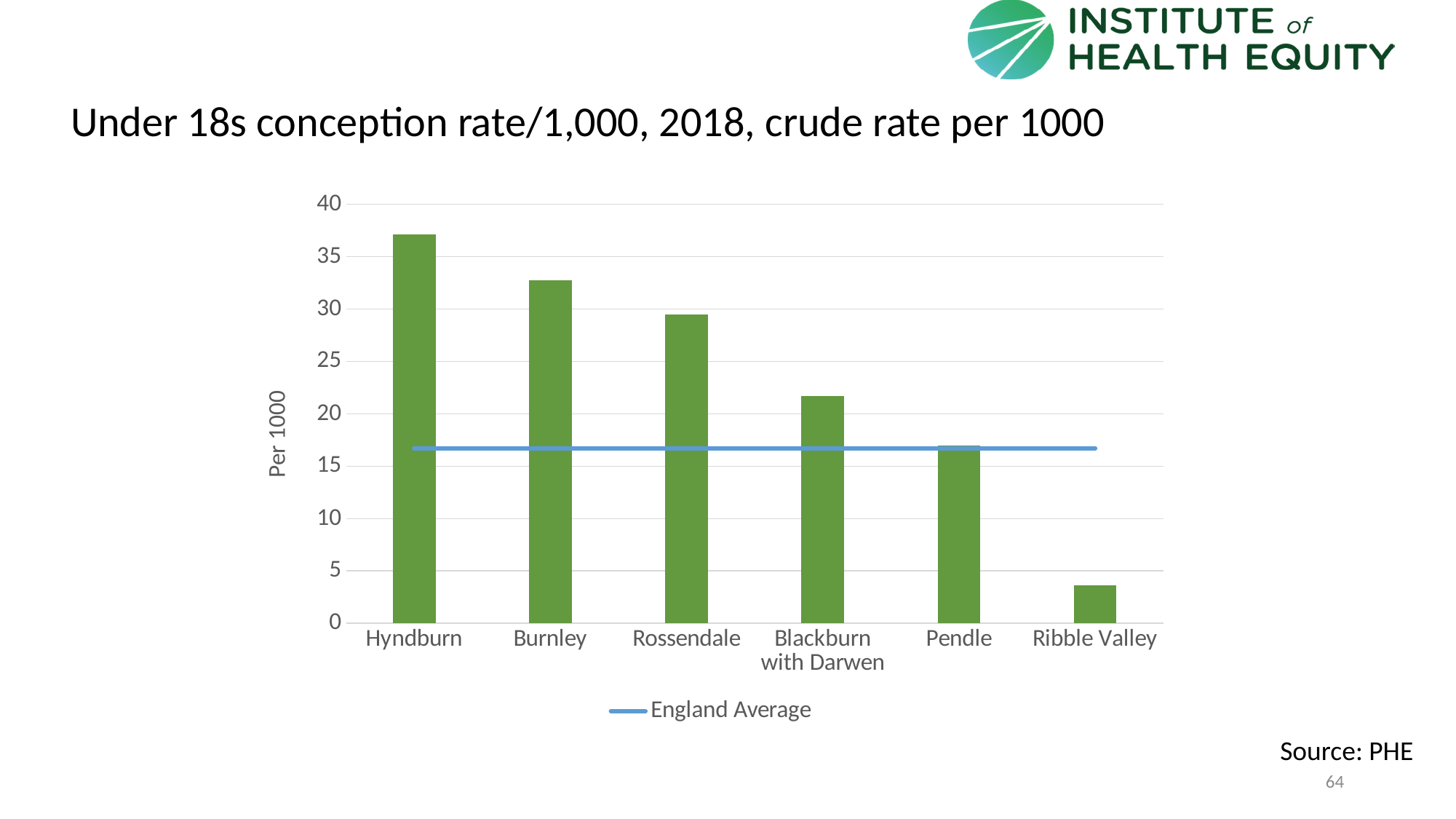
Is the value for Blackburn with Darwen greater or less than 25? less What is the label on the vertical axis of the chart? Per 1000 How many local authorities are shown on the x axis of the chart? 6 Which has a higher under 18s conception rate, Rossendale or Pendle? Rossendale What type of chart is shown on the slide? bar chart Is the value for Hyndburn greater or less than 35? greater Is the value for Ribble Valley greater or less than 5? less What does the horizontal blue line on the chart represent, according to the legend? England Average Do the bar values rise or fall from left to right along the x axis? fall Which local authority has the lowest under 18s conception rate? Ribble Valley Which local authority has the highest under 18s conception rate? Hyndburn